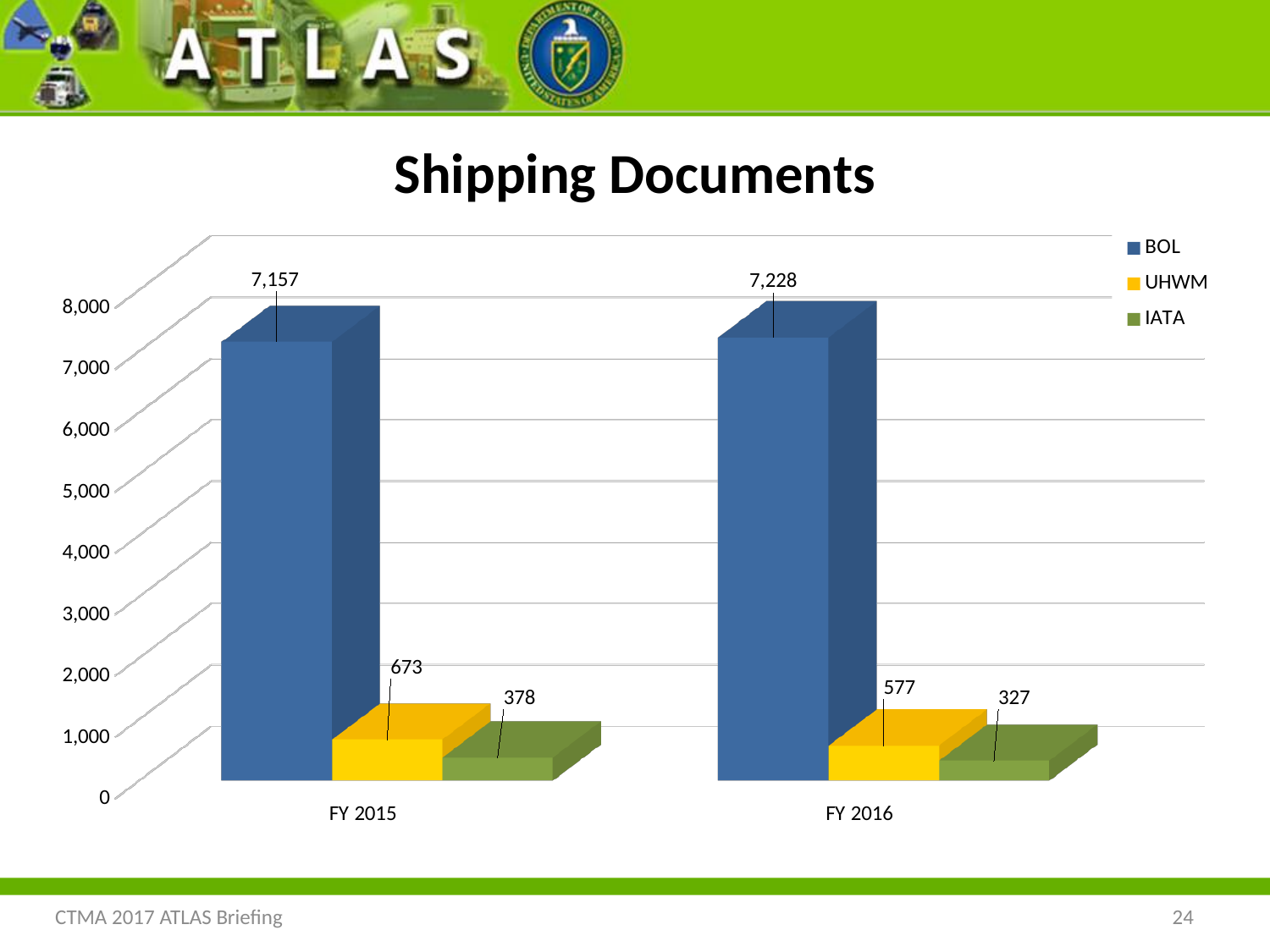
What is the UHWM value for FY 2016? 577 Which series has the lowest value in FY 2015? IATA How many series does the legend list? 3 Which series has the highest value in FY 2016? BOL What is the BOL value for FY 2015? 7,157 Is the BOL value for FY 2016 greater or less than 7,000? greater What kind of chart is shown on the slide? bar chart What is the title of the chart? Shipping Documents What is the difference between the UHWM values for FY 2015 and FY 2016? 96 What is the IATA value for FY 2015? 378 What is the difference between the BOL values for FY 2016 and FY 2015? 71 Which is larger, the IATA value for FY 2015 or for FY 2016? FY 2015